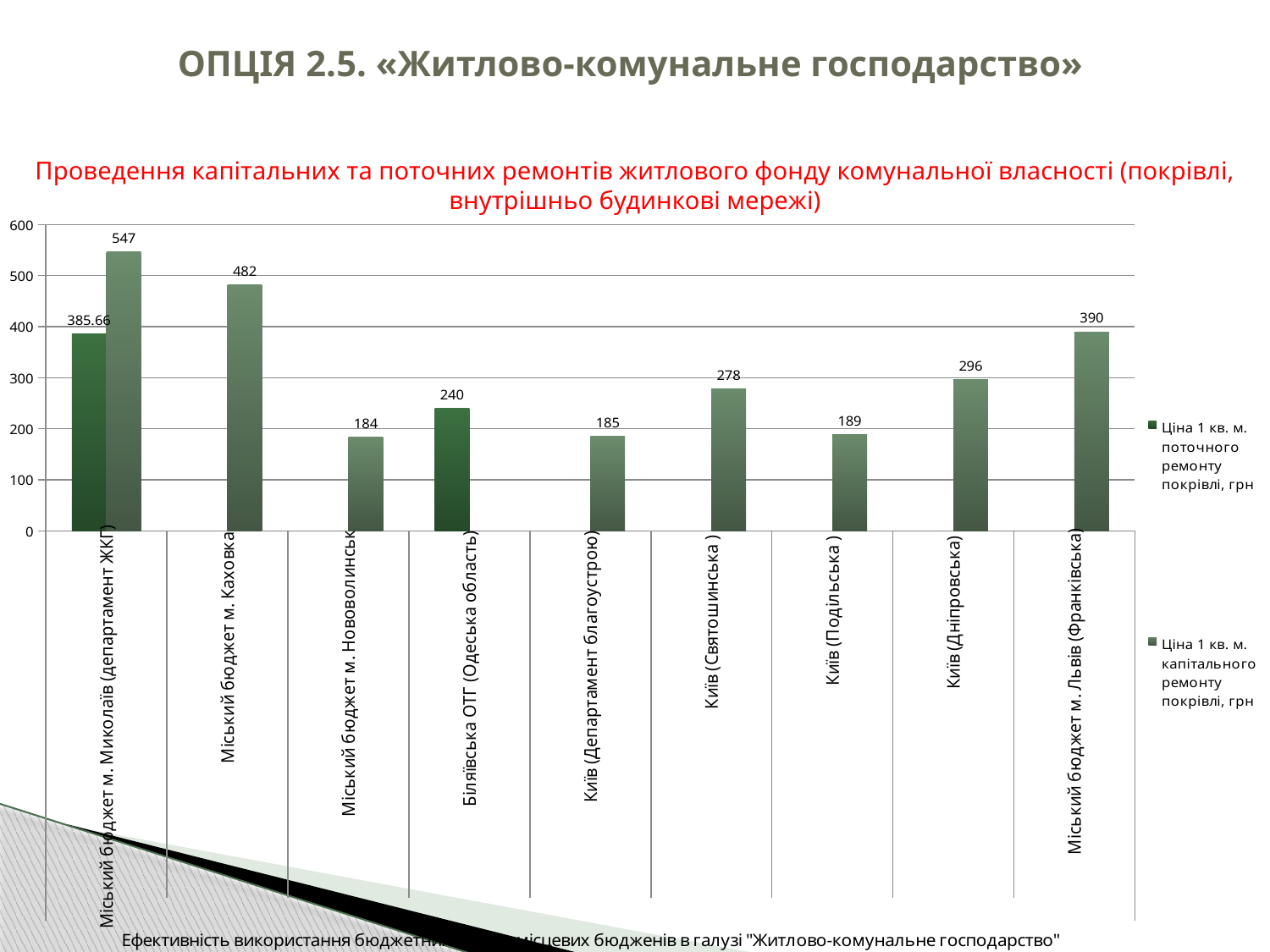
Which has a higher capital roof repair price: Київ (Дніпровська) or Київ (Святошинська)? Київ (Дніпровська) Which category has the highest capital roof repair price per sq. m? Міський бюджет м. Миколаїв (департамент ЖКГ) What type of chart is shown on the slide? Bar chart For Міський бюджет м. Миколаїв (департамент ЖКГ), what is the difference between the capital repair price and the current repair price? 161.34 Which series is shown in the darker green colour in the legend? Ціна 1 кв. м. поточного ремонту покрівлі, грн What is the price per sq. m of capital roof repair (Ціна 1 кв. м. капітального ремонту покрівлі) for Міський бюджет м. Каховка? 482 What is the price per sq. m of current roof repair (Ціна 1 кв. м. поточного ремонту покрівлі) for Міський бюджет м. Миколаїв (департамент ЖКГ)? 385.66 How many series does the legend list? 2 What is the capital roof repair price per sq. m for Київ (Подільська)? 189 How many categories are shown on the x axis of the chart? 9 What value is shown for Біляївська ОТГ (Одеська область)? 240 What is the difference between the capital repair price for Міський бюджет м. Каховка and for Міський бюджет м. Львів (Франківська)? 92